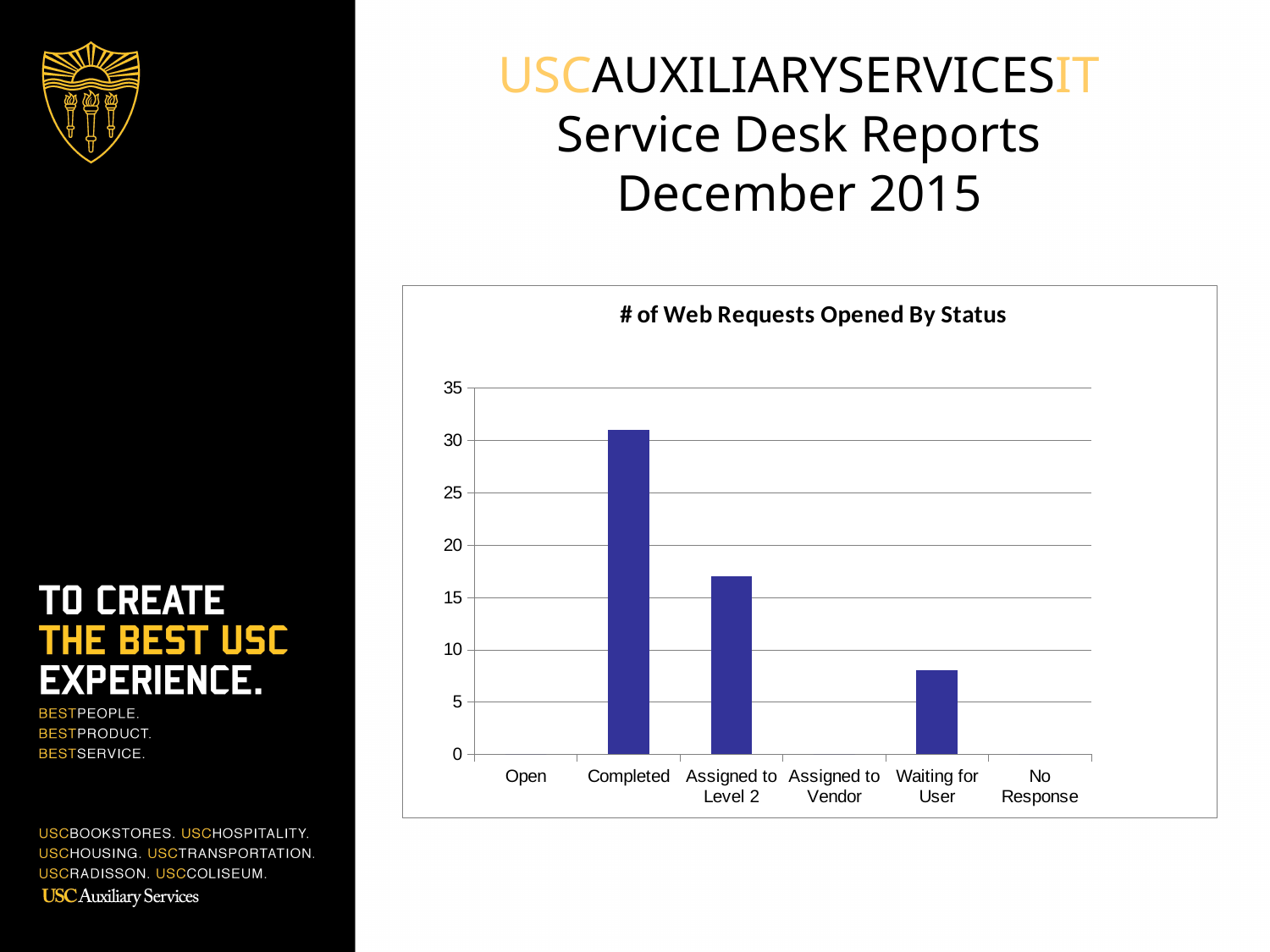
Is the value for Completed greater or less than 25? greater Is the value for Waiting for User greater or less than 10? less What is the title of the chart? # of Web Requests Opened By Status Is the value for Assigned to Level 2 greater or less than 15? greater How many status categories show no visible bar in the chart? 3 Which is larger, the value for Completed or the value for Assigned to Level 2? Completed What kind of chart is shown on the slide? bar chart How many status categories are shown on the x axis of the chart? 6 Which status has the highest number of web requests opened? Completed Which is larger, the value for Assigned to Level 2 or the value for Waiting for User? Assigned to Level 2